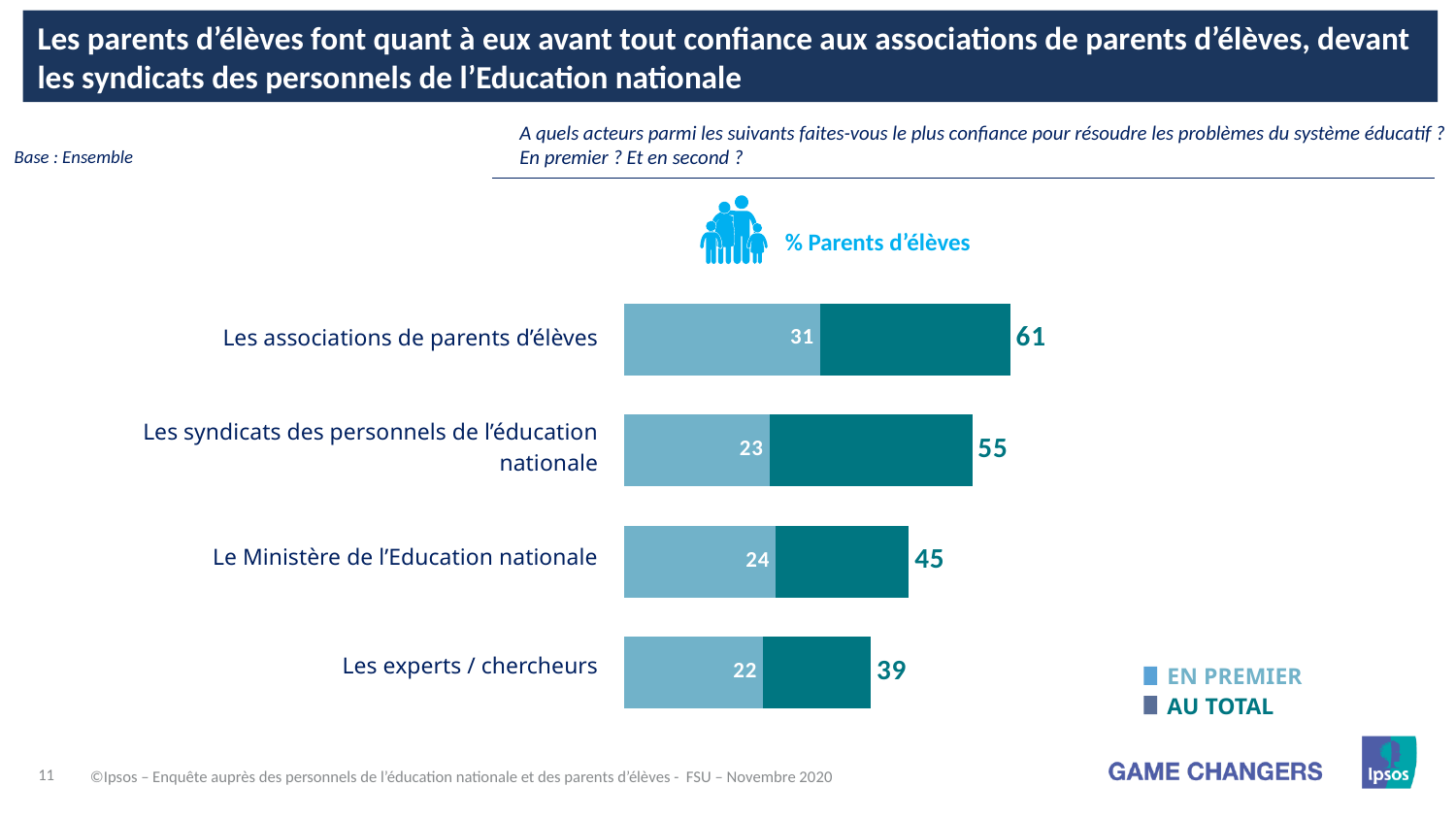
What kind of chart is shown on the slide? Bar chart How many categories are shown in the chart? 4 What are the two series named in the legend? EN PREMIER and AU TOTAL What is the 'AU TOTAL' value for 'Le Ministère de l'Education nationale'? 45 Which category has the lowest 'AU TOTAL' value? Les experts / chercheurs What is the 'AU TOTAL' value for 'Les associations de parents d'élèves'? 61 Which category has the highest 'AU TOTAL' value? Les associations de parents d'élèves How many series does the legend list? 2 What is the difference between the 'AU TOTAL' values for 'Les associations de parents d'élèves' and 'Les syndicats des personnels de l'éducation nationale'? 6 What is the 'EN PREMIER' value for 'Les syndicats des personnels de l'éducation nationale'? 23 What is the 'EN PREMIER' value for 'Les experts / chercheurs'? 22 Which has a larger 'EN PREMIER' value: 'Le Ministère de l'Education nationale' or 'Les experts / chercheurs'? Le Ministère de l'Education nationale